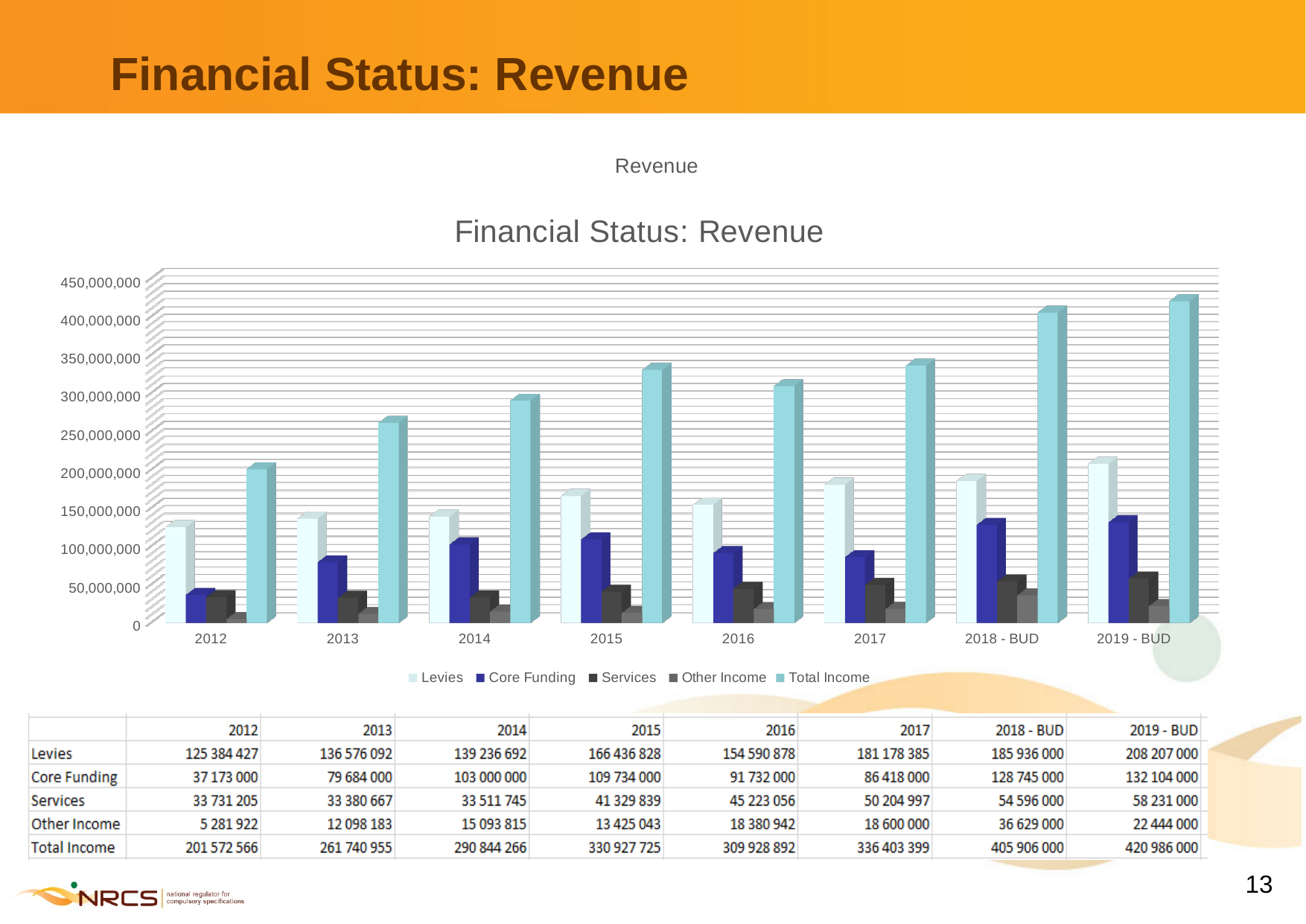
What is the Levies value for 2019 - BUD? 208 207 000 What is the Core Funding value for 2014? 103 000 000 Which is larger, Core Funding in 2015 or Core Funding in 2016? 2015 How many series does the legend list? 5 What is the Other Income value for 2018 - BUD? 36 629 000 Which year has the highest Total Income? 2019 - BUD Is the Total Income for 2015 greater or less than 300,000,000? greater What kind of chart is shown on the slide? bar chart How many year categories are shown on the x axis? 8 What is the difference in Total Income between 2019 - BUD and 2018 - BUD? 15 080 000 What is the Total Income value for 2012? 201 572 566 Which year has the lowest Other Income? 2012